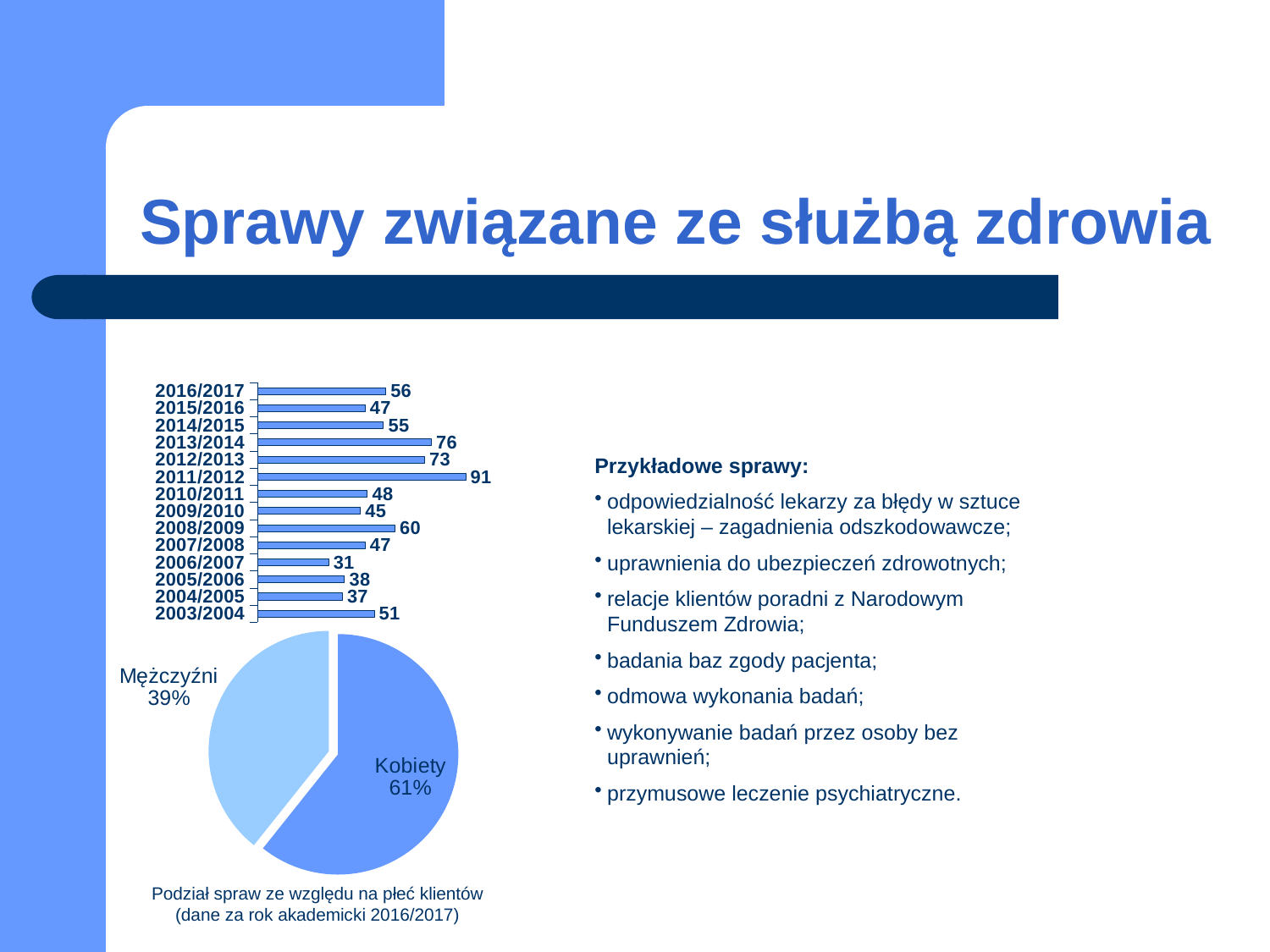
In the bar chart at the top left, what is the value for 2003/2004? 51 In the bar chart at the top left, how many academic years are shown? 14 In the bar chart at the top left, what is the value for 2016/2017? 56 In the pie chart at the bottom left, what share is labelled Mężczyźni? 39% In the bar chart at the top left, which is larger, the value for 2008/2009 or the value for 2009/2010? 2008/2009 In the pie chart at the bottom left, how many slices are there? 2 In the bar chart at the top left, which academic year has the highest value? 2011/2012 What type of chart is the chart at the top left of the slide? Bar chart In the pie chart at the bottom left, what share is labelled Kobiety? 61% In the bar chart at the top left, what is the value for 2011/2012? 91 In the bar chart at the top left, what is the difference between the values for 2013/2014 and 2012/2013? 3 In the bar chart at the top left, which academic year has the lowest value? 2006/2007